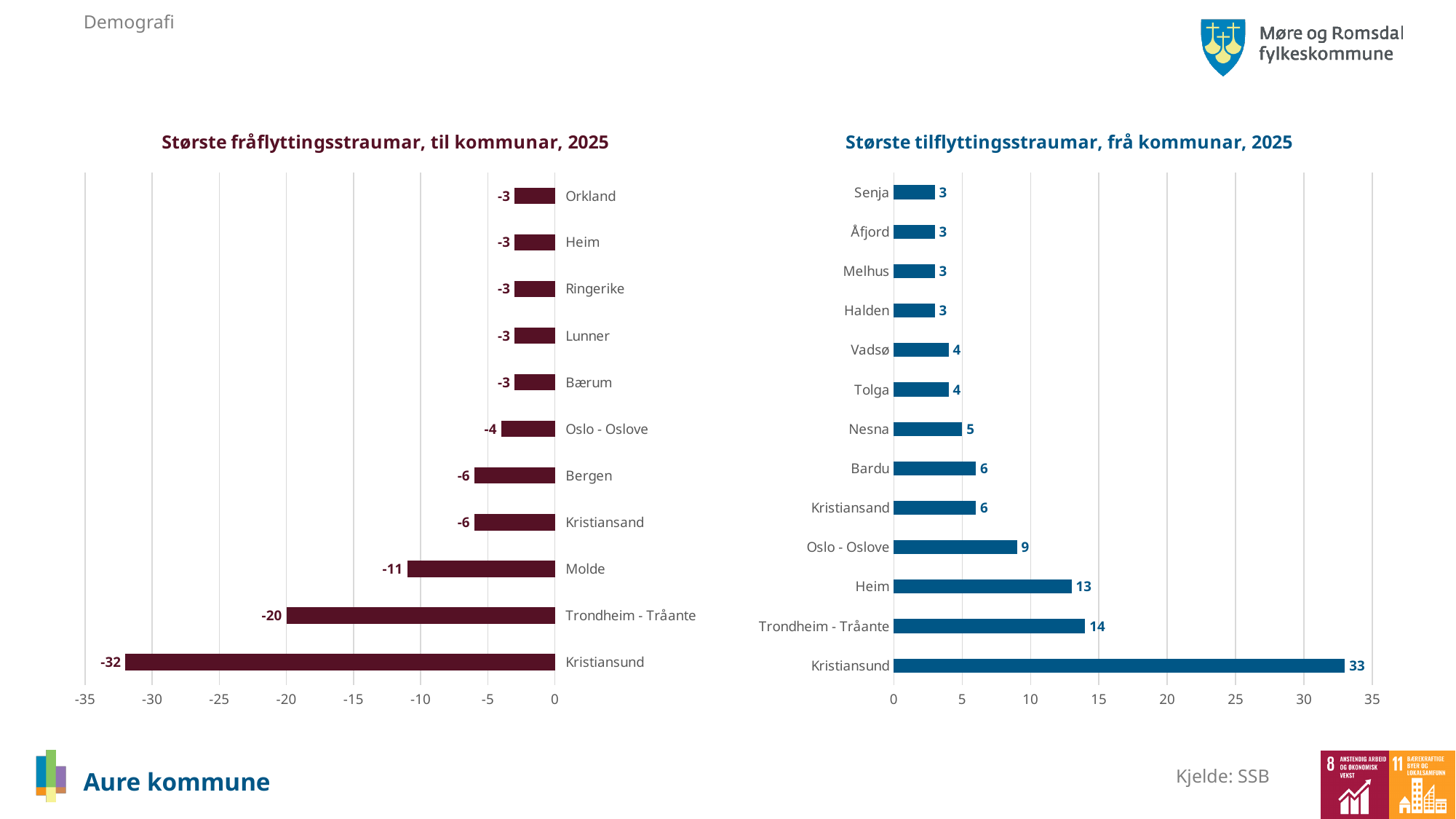
In the chart 'Største tilflyttingsstraumar, frå kommunar, 2025', is the value for Kristiansund greater or less than 30? greater How many municipalities are shown in the chart 'Største fråflyttingsstraumar, til kommunar, 2025'? 11 In the chart 'Største fråflyttingsstraumar, til kommunar, 2025', what is the value for Molde? -11 What type of chart is the chart on the left of the slide? Bar chart How many municipalities are shown in the chart 'Største tilflyttingsstraumar, frå kommunar, 2025'? 13 In the chart 'Største fråflyttingsstraumar, til kommunar, 2025', which municipality has the lowest (most negative) value? Kristiansund What is the title of the chart on the right of the slide? Største tilflyttingsstraumar, frå kommunar, 2025 In the chart 'Største fråflyttingsstraumar, til kommunar, 2025', what is the difference between the values for Trondheim - Tråante and Molde? 9 In the chart 'Største tilflyttingsstraumar, frå kommunar, 2025', which is larger, the value for Oslo - Oslove or the value for Bardu? Oslo - Oslove In the chart 'Største tilflyttingsstraumar, frå kommunar, 2025', what is the difference between the values for Kristiansund and Trondheim - Tråante? 19 In the chart 'Største tilflyttingsstraumar, frå kommunar, 2025', which municipality has the highest value? Kristiansund In the chart 'Største tilflyttingsstraumar, frå kommunar, 2025', what is the value for Heim? 13